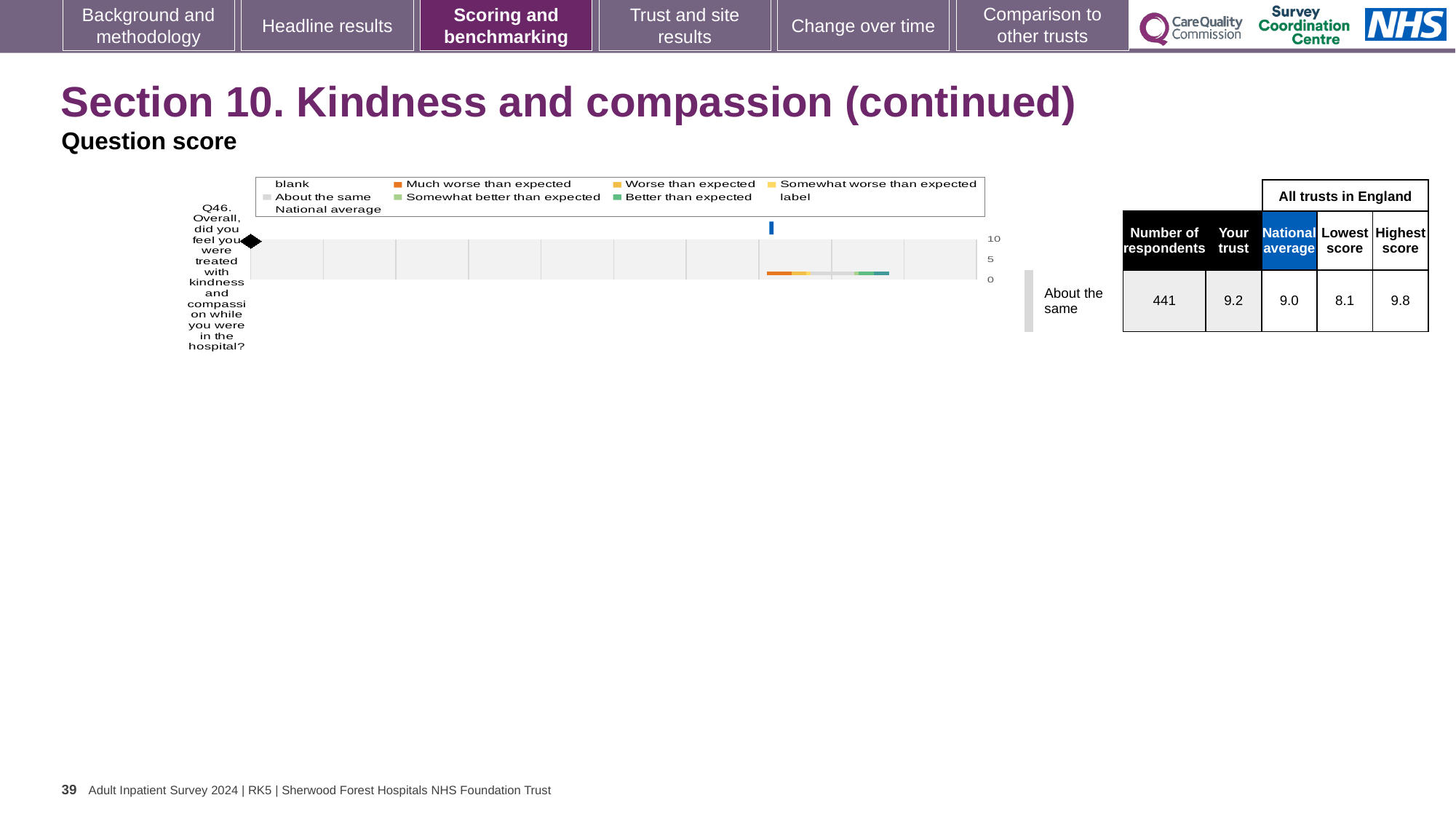
According to the table beside the chart, how many respondents answered Q46? 441 Which is larger for Q46, the 'Your trust' score or the national average? Your trust What is the difference between the highest score (9.8) and the lowest score (8.1) for Q46? 1.7 What is the highest value shown on the chart's axis? 10 Which question number is plotted on the chart? Q46 According to the table beside the chart, what is the lowest score among all trusts in England for Q46? 8.1 According to the table beside the chart, what is the national average score for Q46? 9.0 How many questions (categories) are plotted on the chart? 1 According to the table beside the chart, what is the highest score among all trusts in England for Q46? 9.8 What kind of chart is shown on the slide? bar chart What benchmark category is shown for Q46 next to the chart? About the same According to the table beside the chart, what is the 'Your trust' score for Q46? 9.2